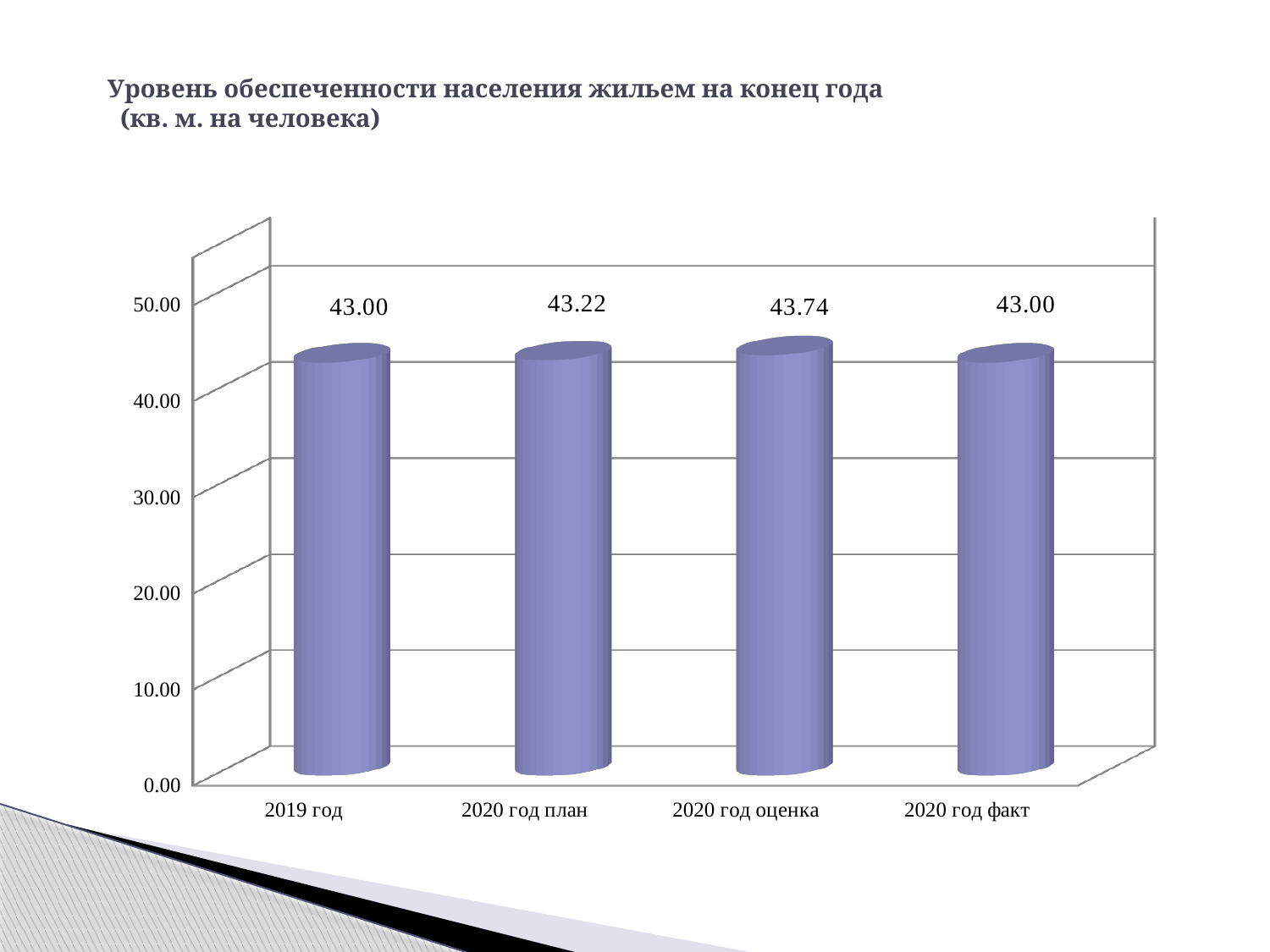
Which is larger, the value for 2020 год план or the value for 2019 год? 2020 год план What is the difference between the values for 2020 год оценка and 2020 год факт? 0.74 What is the value for 2020 год оценка? 43.74 What unit is given in the chart title? кв. м. на человека What is the value for 2020 год факт? 43.00 What kind of chart is shown on the slide? bar chart What is the value for 2019 год? 43.00 Which category has the highest value? 2020 год оценка How many categories are shown on the x axis? 4 What is the difference between the values for 2020 год оценка and 2020 год план? 0.52 What is the value for 2020 год план? 43.22 Is the value for 2020 год факт greater or less than 40.00? greater